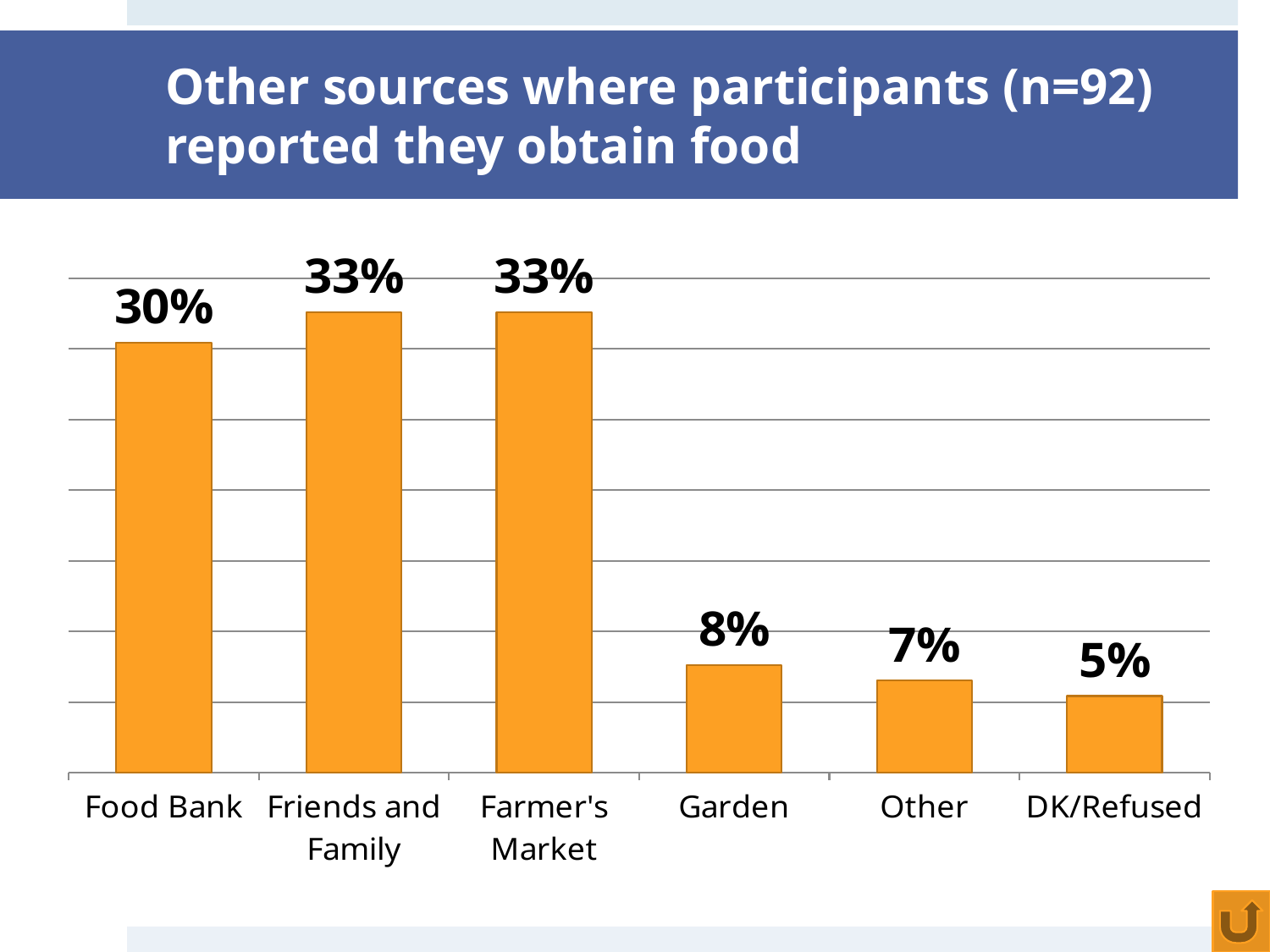
What value is shown for Garden? 8% What is the difference between the values for Friends and Family and Food Bank? 3 percentage points What kind of chart is shown on the slide? Bar chart Which category has the lowest value? DK/Refused What value is shown for DK/Refused? 5% What is the title of the chart? Other sources where participants (n=92) reported they obtain food What is the difference between the values for Food Bank and DK/Refused? 25 percentage points What percentage of participants reported obtaining food from a Food Bank? 30% How many categories are shown on the x axis? 6 Which is larger, the value for Garden or the value for Other? Garden What percentage is shown for Farmer's Market? 33% Which is larger, the value for Food Bank or the value for Farmer's Market? Farmer's Market